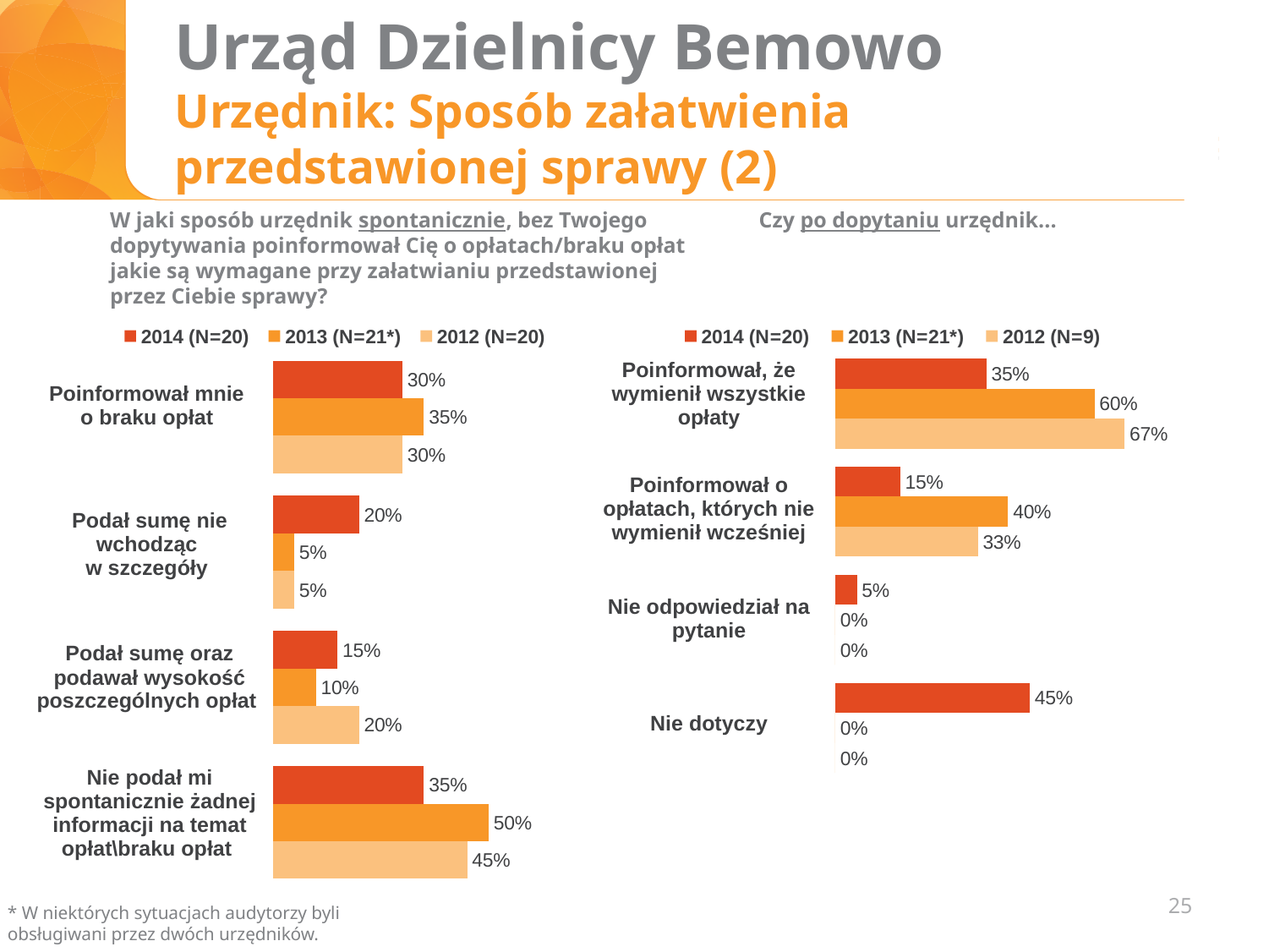
In the right chart, what is the 2013 (N=21*) value for "Poinformował o opłatach, których nie wymienił wcześniej"? 40% How many series does the legend of the right chart list? 3 What kind of chart is the right chart? Bar chart In the left chart, which is larger for "Podał sumę oraz podawał wysokość poszczególnych opłat": the 2012 (N=20) value or the 2013 (N=21*) value? 2012 (N=20) In the right chart, which category has the lowest 2014 (N=20) value? Nie odpowiedział na pytanie In the right chart, what is the 2014 (N=20) value for "Nie dotyczy"? 45% In the right chart, what is the 2012 (N=9) value for "Poinformował, że wymienił wszystkie opłaty"? 67% In the right chart, what is the difference between the 2013 (N=21*) and 2014 (N=20) values for "Poinformował, że wymienił wszystkie opłaty"? 25% In the left chart, what is the 2013 (N=21*) value for "Nie podał mi spontanicznie żadnej informacji na temat opłat\braku opłat"? 50% How many categories does the left chart show? 4 In the left chart, what is the 2014 (N=20) value for "Podał sumę nie wchodząc w szczegóły"? 20% In the left chart, which category has the highest 2013 (N=21*) value? Nie podał mi spontanicznie żadnej informacji na temat opłat\braku opłat